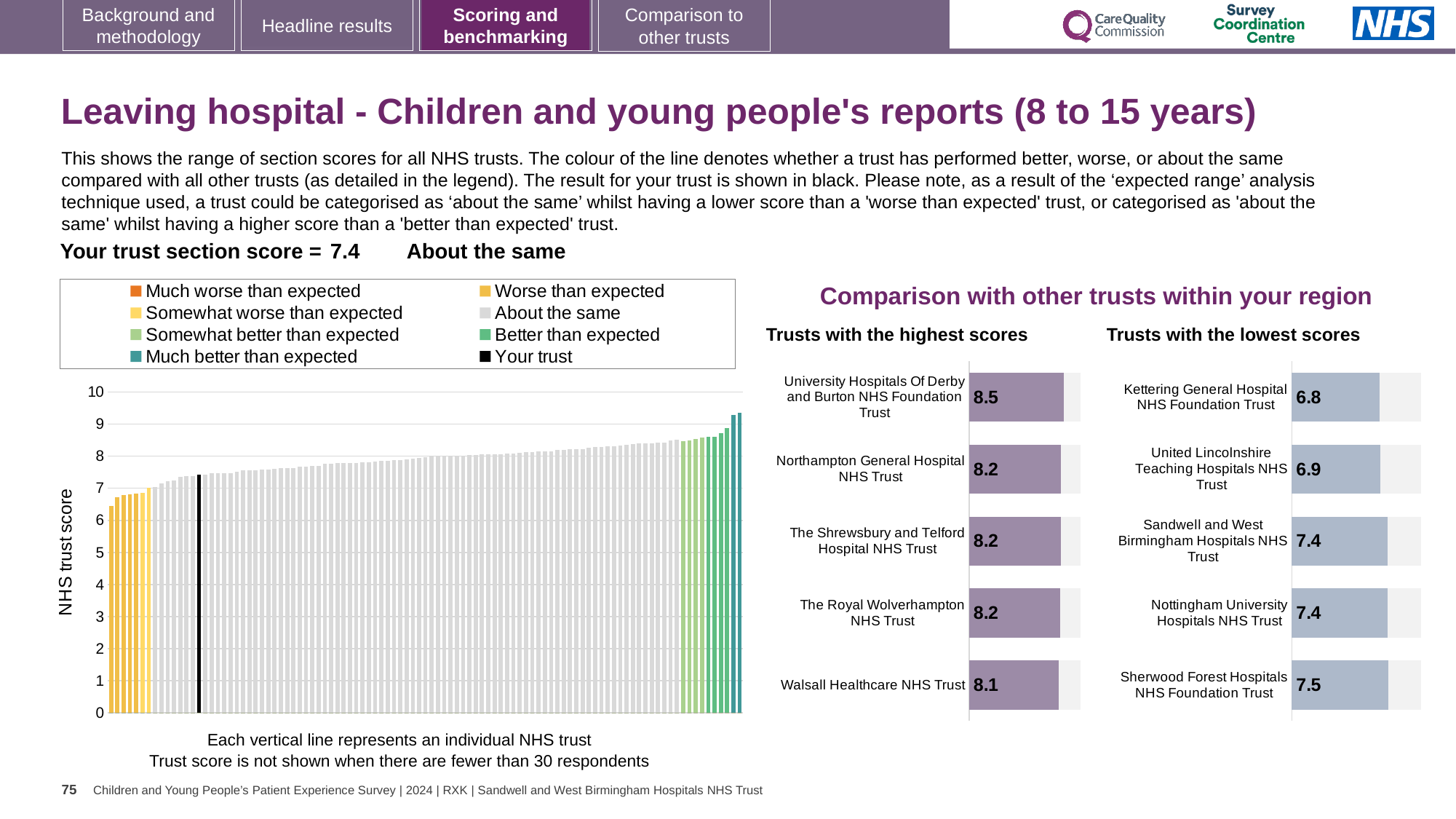
In the main chart on the left showing the range of section scores for all NHS trusts, do the bar values rise or fall from left to right? rise In the 'Trusts with the highest scores' chart, which has the larger score: Northampton General Hospital NHS Trust or Walsall Healthcare NHS Trust? Northampton General Hospital NHS Trust How many trusts are shown in the 'Trusts with the lowest scores' chart? 5 In the 'Trusts with the highest scores' chart, what is the score for Walsall Healthcare NHS Trust? 8.1 In the 'Trusts with the lowest scores' chart, what is the score for Sherwood Forest Hospitals NHS Foundation Trust? 7.5 How many entries does the legend of the main chart on the left list? 8 In the main chart on the left showing the range of section scores for all NHS trusts, is the value for the black 'Your trust' bar greater or less than 7? greater In the 'Trusts with the lowest scores' chart, which trust has the lowest score? Kettering General Hospital NHS Foundation Trust In the 'Trusts with the highest scores' chart, which trust has the highest score? University Hospitals Of Derby and Burton NHS Foundation Trust In the 'Trusts with the highest scores' chart, what is the score for University Hospitals Of Derby and Burton NHS Foundation Trust? 8.5 In the 'Trusts with the lowest scores' chart, what is the difference between the scores of Sherwood Forest Hospitals NHS Foundation Trust and Kettering General Hospital NHS Foundation Trust? 0.7 In the 'Trusts with the lowest scores' chart, what is the score for Kettering General Hospital NHS Foundation Trust? 6.8